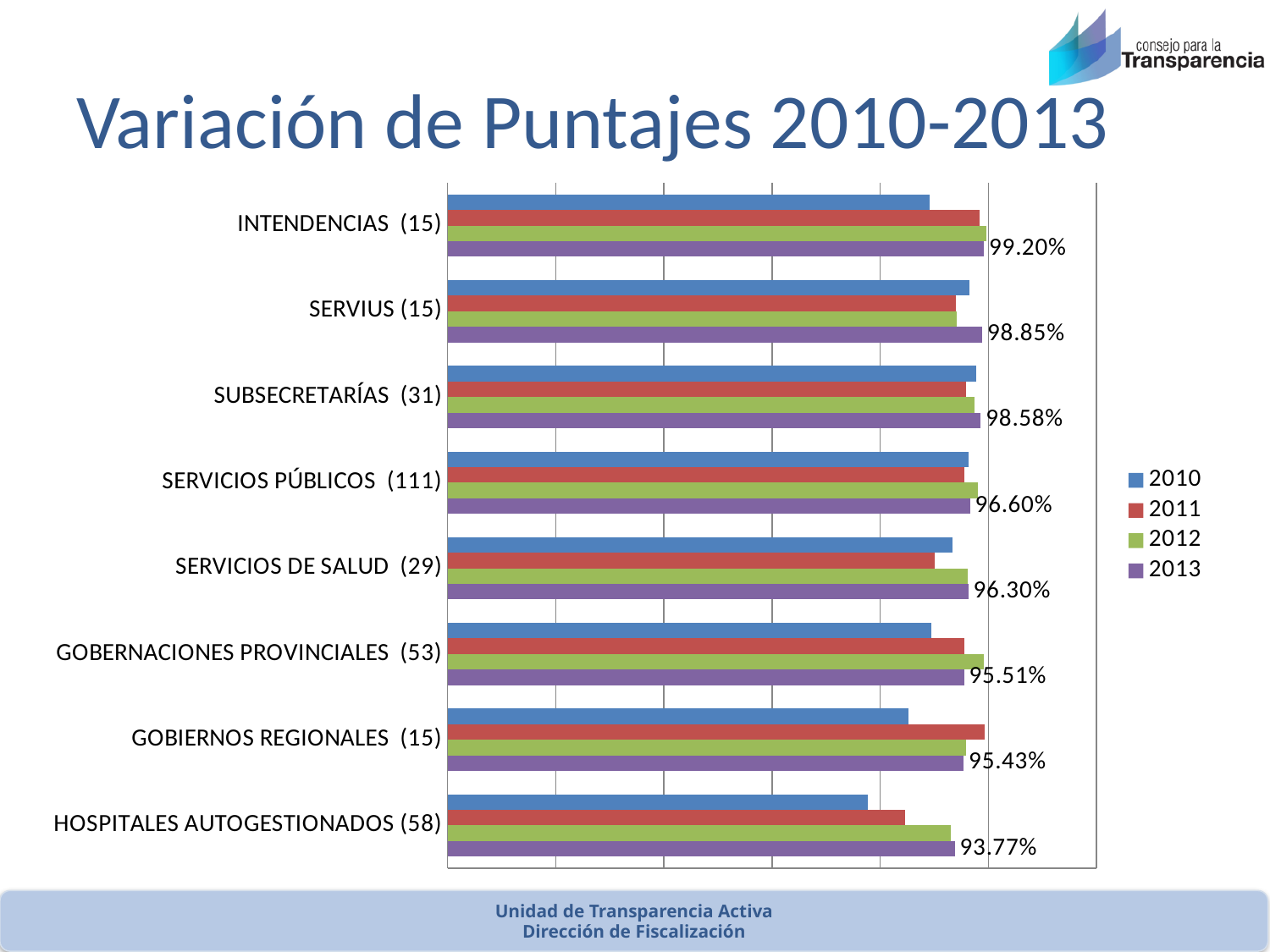
What is the 2013 value for HOSPITALES AUTOGESTIONADOS (58)? 93.77% How many categories are shown on the chart? 8 How many series does the legend list? 4 What is the 2013 value for INTENDENCIAS (15)? 99.20% Which has the larger 2013 value, SERVIUS (15) or SUBSECRETARÍAS (31)? SERVIUS (15) What is the difference between the 2013 values for INTENDENCIAS (15) and HOSPITALES AUTOGESTIONADOS (58)? 5.43 percentage points Which category has the lowest 2013 value? HOSPITALES AUTOGESTIONADOS (58) For HOSPITALES AUTOGESTIONADOS (58), is the 2010 bar longer or shorter than the 2013 bar? shorter What type of chart is shown on the slide? bar chart What is the 2013 value for SERVICIOS DE SALUD (29)? 96.30% What is the 2013 value for GOBERNACIONES PROVINCIALES (53)? 95.51% Which category has the highest 2013 value? INTENDENCIAS (15)